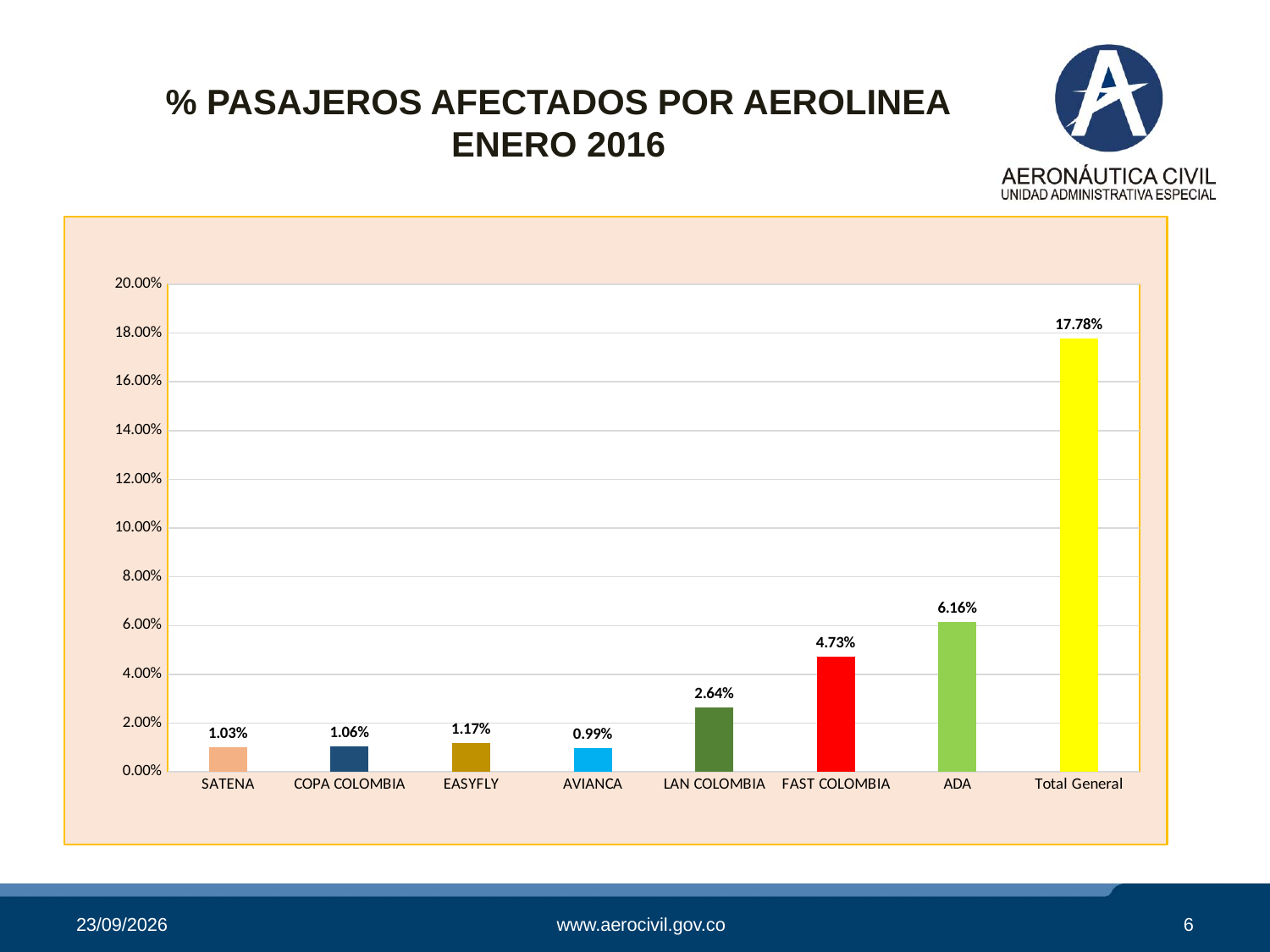
What is the value for ADA? 6.16% How many categories are shown on the x axis? 8 What is the difference between the values for ADA and FAST COLOMBIA? 1.43% What is the value for FAST COLOMBIA? 4.73% What is the value for LAN COLOMBIA? 2.64% Which category has the highest value? Total General What is the value for Total General? 17.78% Is the value for Total General greater or less than 16.00%? greater What kind of chart is shown on the slide? bar chart Which category has the lowest value? AVIANCA What is the title of the slide above the chart? % PASAJEROS AFECTADOS POR AEROLINEA ENERO 2016 Which is larger, the value for EASYFLY or the value for SATENA? EASYFLY